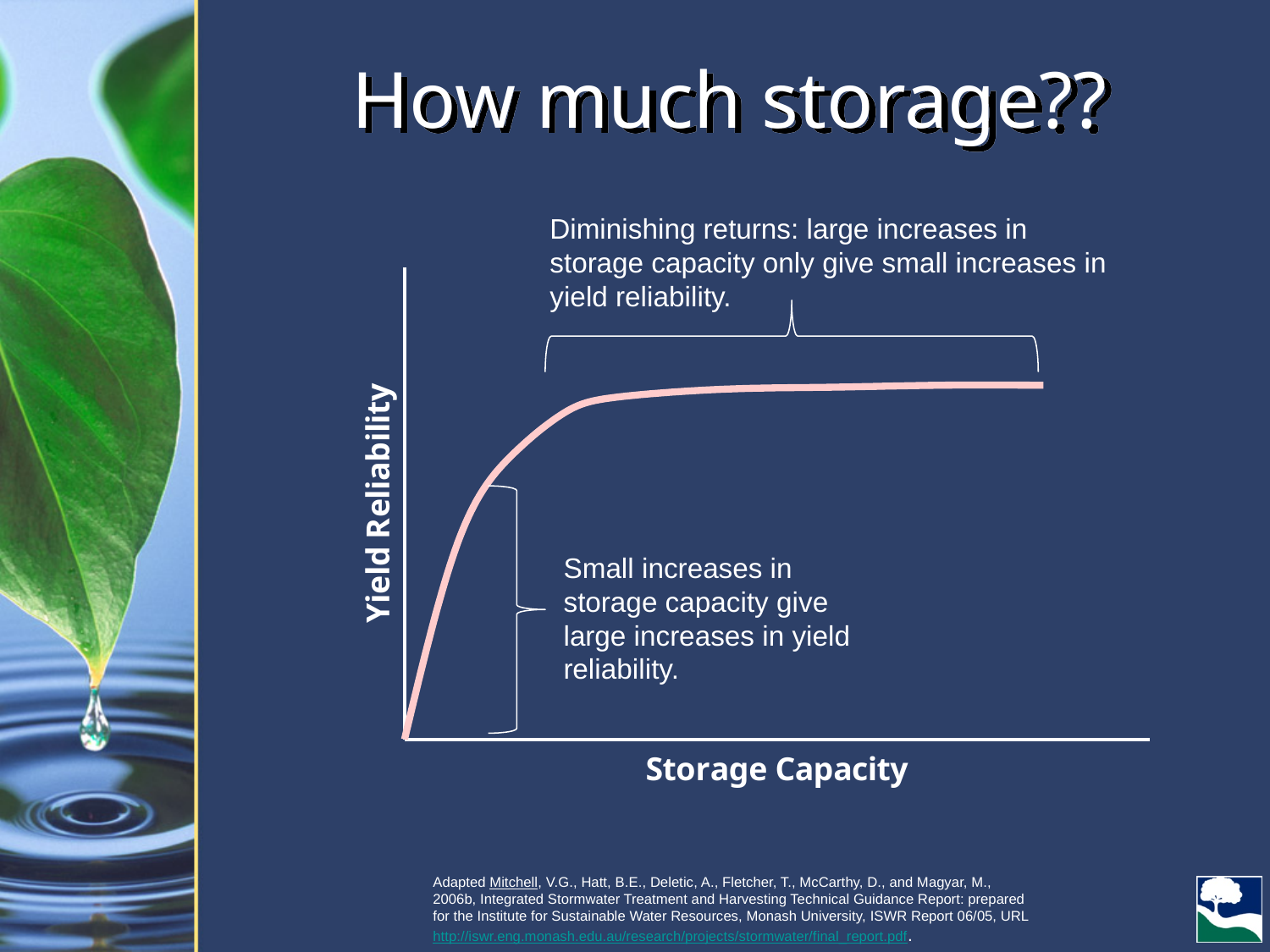
According to the chart's annotation, do large increases in storage capacity at the right of the curve give large or small increases in yield reliability? small How many lines are plotted on the chart? 1 What is the label on the horizontal axis of the chart? Storage Capacity According to the chart's annotation, do small increases in storage capacity at the left of the curve give large or small increases in yield reliability? large Is the curve steeper at low storage capacity or at high storage capacity? low storage capacity What is the label on the vertical axis of the chart? Yield Reliability What kind of chart is shown on the slide? line chart Does yield reliability rise or fall as storage capacity increases along the x axis? rise